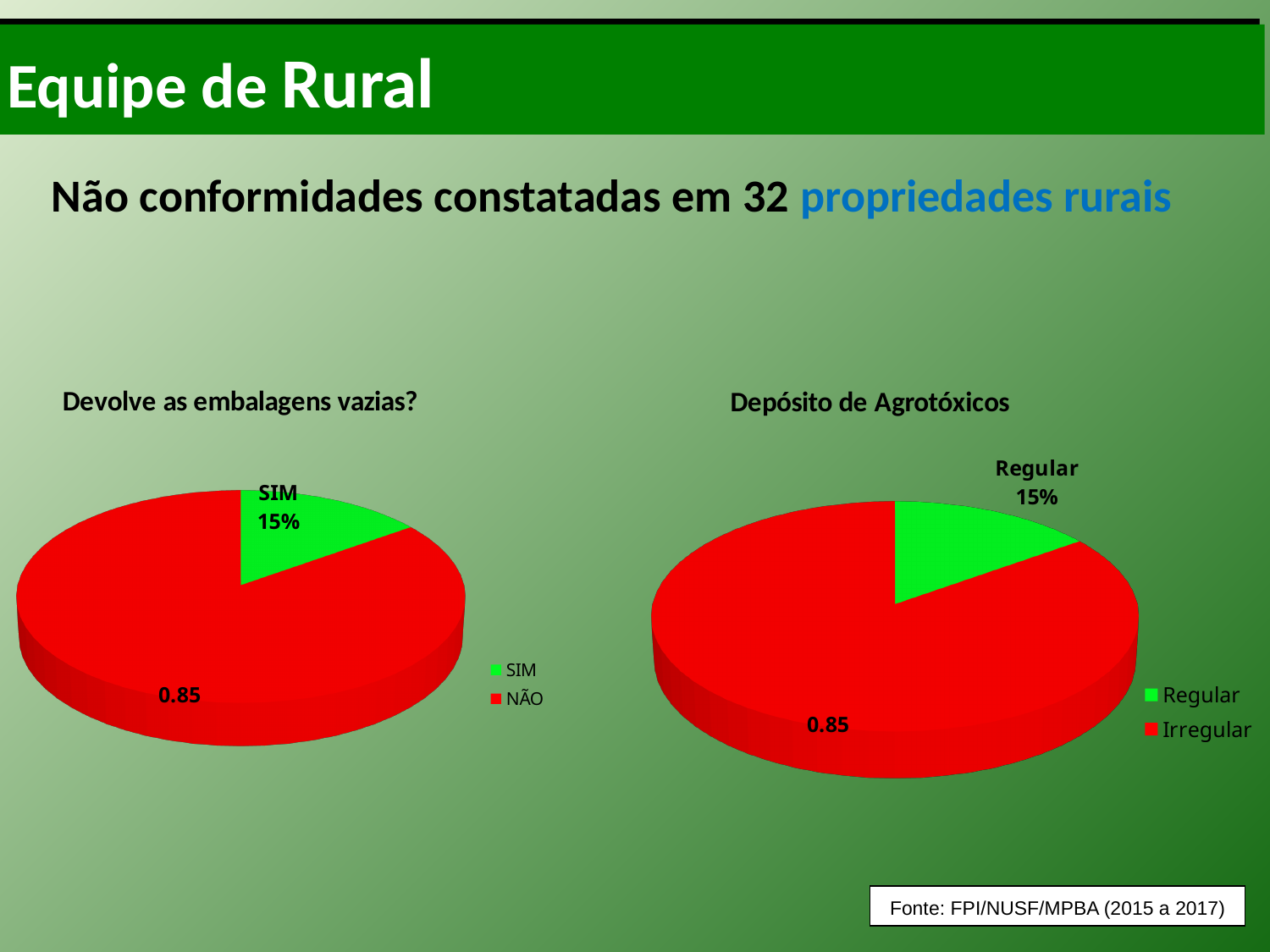
In the chart titled "Depósito de Agrotóxicos", what is the value shown for Irregular? 0.85 In the chart titled "Devolve as embalagens vazias?", what is the value shown for NÃO? 0.85 What kind of chart is the chart titled "Devolve as embalagens vazias?"? Pie chart In the chart titled "Devolve as embalagens vazias?", which category has the largest slice? NÃO In the chart titled "Depósito de Agrotóxicos", which category has the smallest slice? Regular In the chart titled "Devolve as embalagens vazias?", what is the value shown for SIM? 15% How many entries does the legend of the chart titled "Devolve as embalagens vazias?" list? 2 What is the title of the pie chart on the right side of the slide? Depósito de Agrotóxicos In the chart titled "Depósito de Agrotóxicos", what is the value shown for Regular? 15% In the chart titled "Devolve as embalagens vazias?", what colour is the SIM slice? Green In the chart titled "Depósito de Agrotóxicos", which is larger, Regular or Irregular? Irregular How many categories does the chart titled "Depósito de Agrotóxicos" show? 2